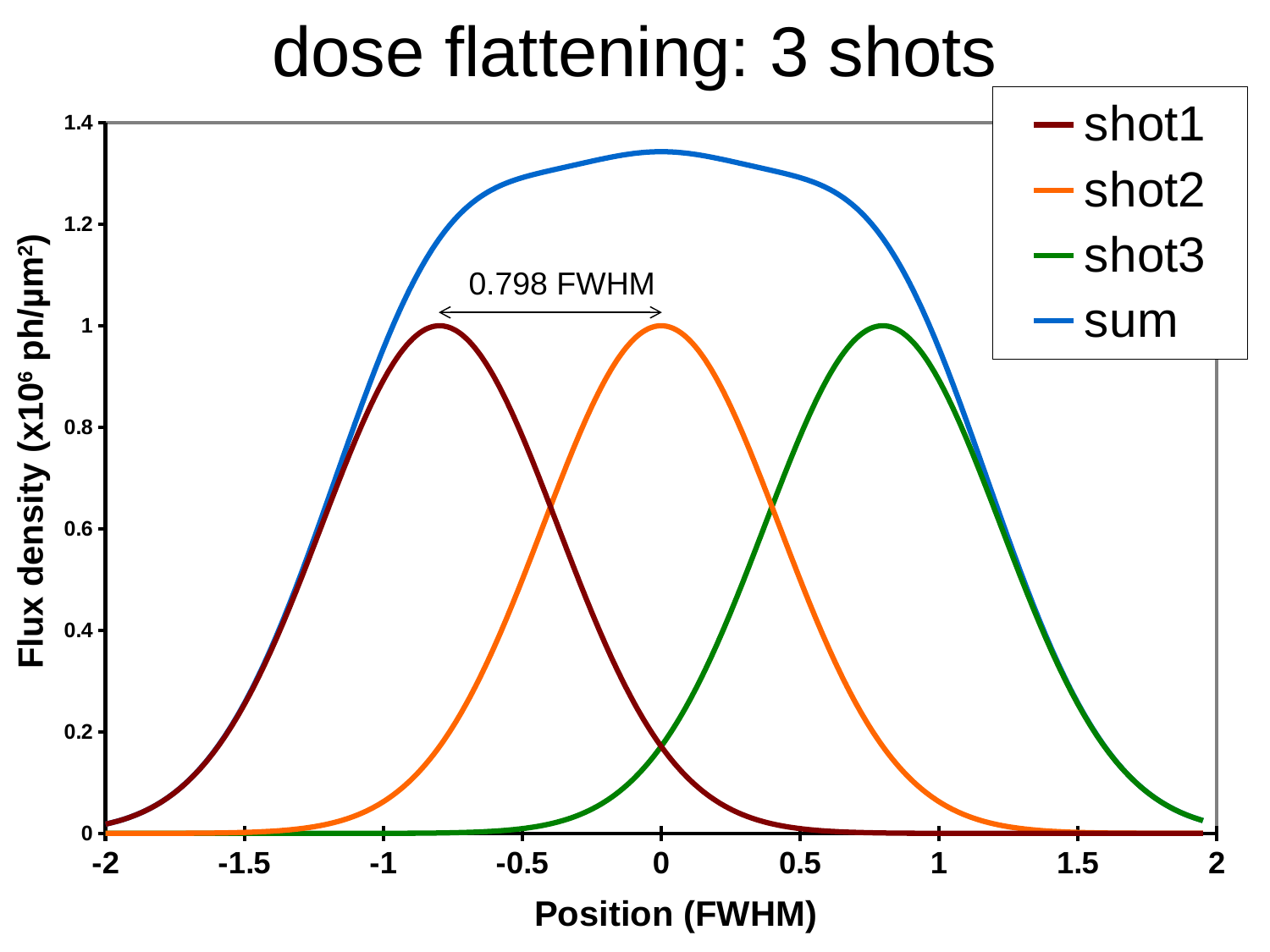
At position 0, which is larger, the sum curve or the shot2 curve? sum How many series does the legend list? 4 Is the value of the sum curve at position 0 greater or less than 1.2? greater What is the label of the x axis? Position (FWHM) Does the sum curve rise or fall as position goes from -2 to 0? rise What is the peak value of the shot2 curve? 1 What spacing between shots is annotated on the chart? 0.798 FWHM Does the shot1 curve rise or fall as position goes from -0.5 to 0.5? fall Which series reaches the highest value on the chart? sum What kind of chart is shown on the slide? line chart Is the value of the shot3 curve at position -1 greater or less than 0.2? less What is the title of the chart? dose flattening: 3 shots